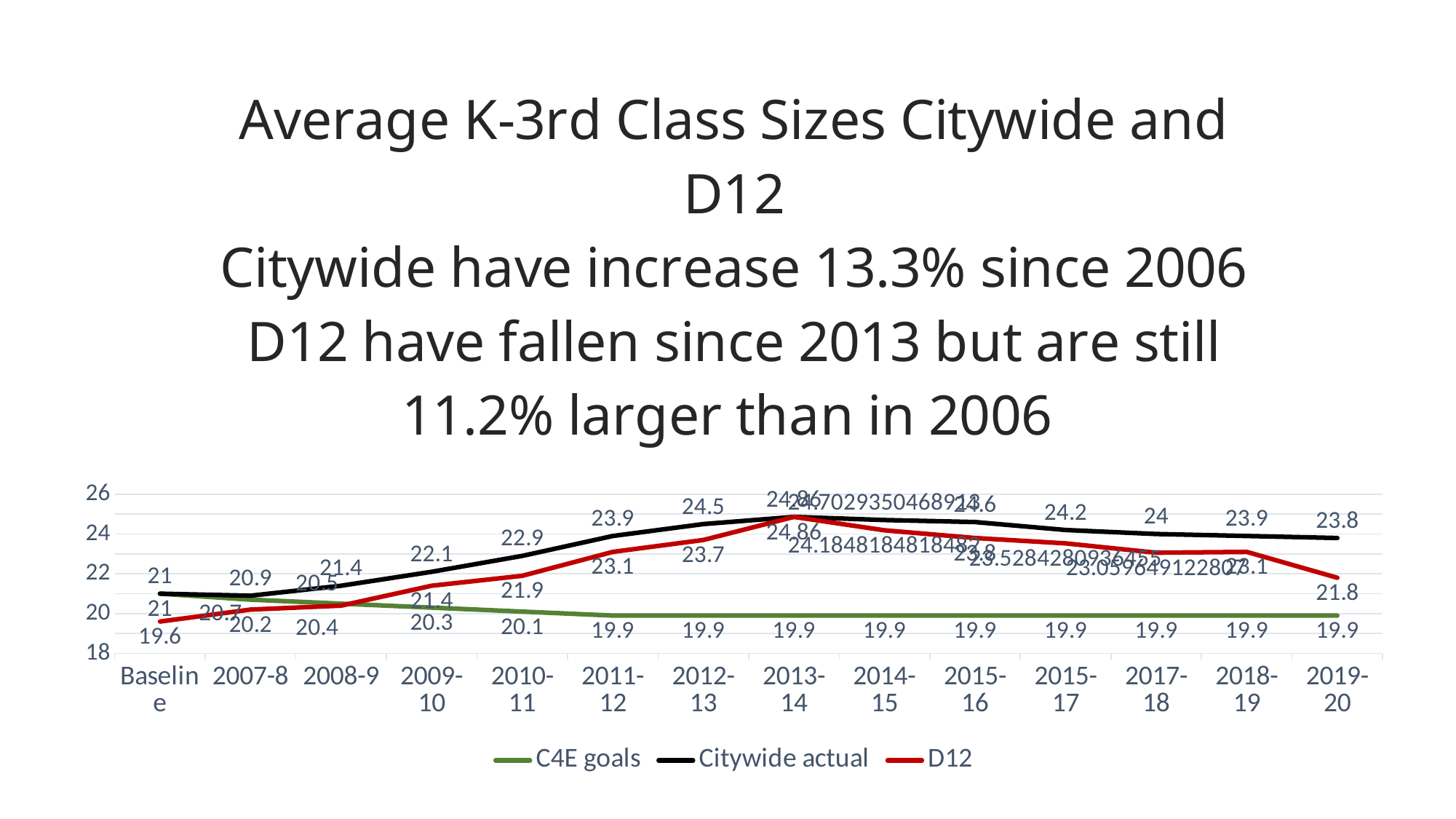
How many series does the legend list? 3 What type of chart is shown on the slide? line chart In which year does the Citywide actual series reach its lowest value? 2007-8 Which is larger in 2011-12, the Citywide actual value or the D12 value? Citywide actual What is the Citywide actual value for 2012-13? 24.5 What is the C4E goals value for 2010-11? 20.1 What is the D12 value for 2019-20? 21.8 What is the D12 value at Baseline? 19.6 Does the C4E goals series rise or fall from Baseline to 2019-20? fall What is the difference between the Citywide actual and D12 values in 2019-20? 2 How many categories are shown on the x axis? 14 Which series is drawn in red in the legend? D12